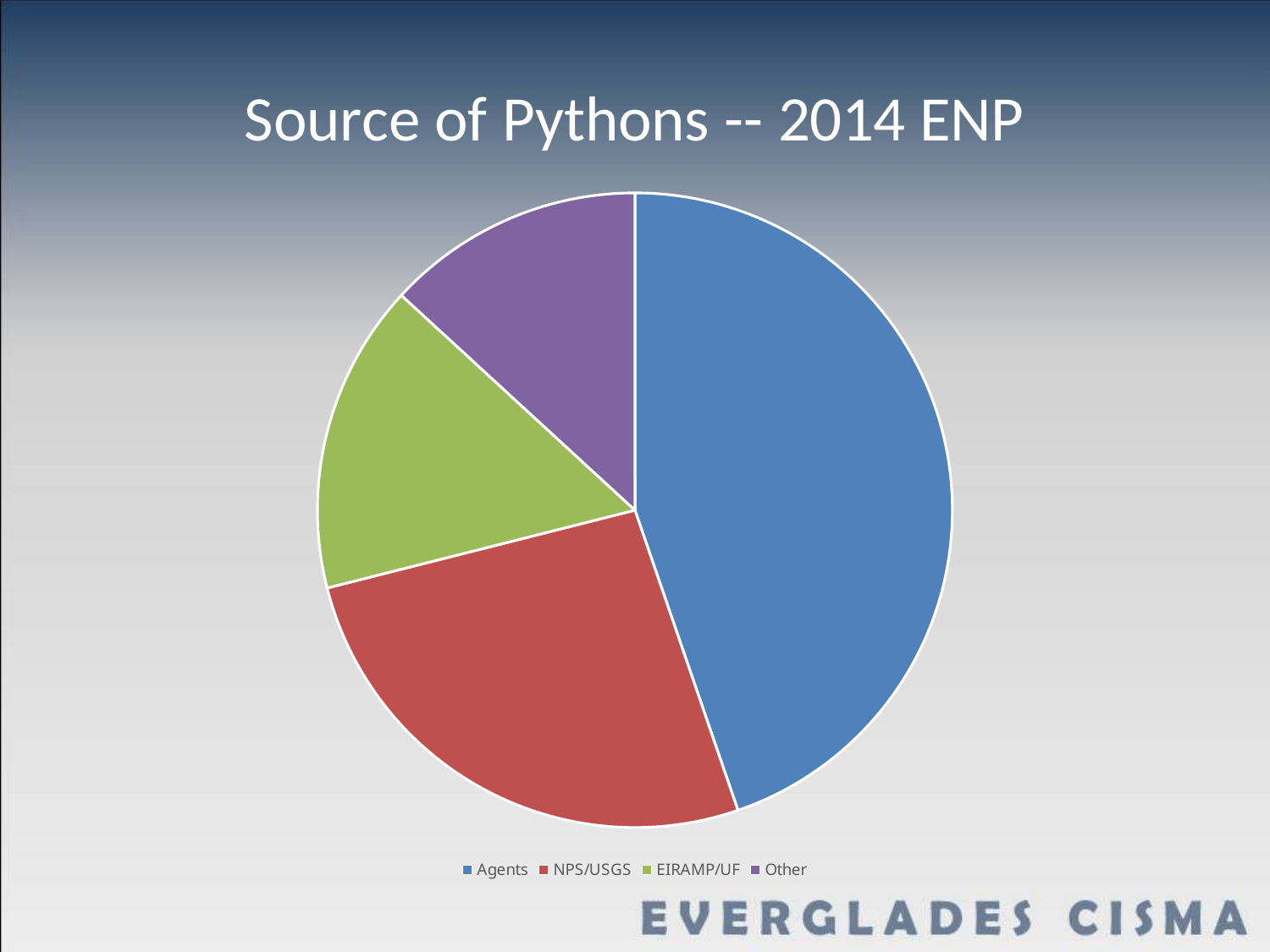
What is the title of the chart? Source of Pythons -- 2014 ENP Which source accounts for the largest slice of the pie? Agents Which slice is larger, Agents or NPS/USGS? Agents How many entries does the legend list? 4 Which slice is larger, NPS/USGS or EIRAMP/UF? NPS/USGS What colour is the Agents slice in the pie chart? blue How many slices does the pie chart have? 4 What kind of chart is shown on the slide? pie chart Which slice is larger, Agents or EIRAMP/UF? Agents